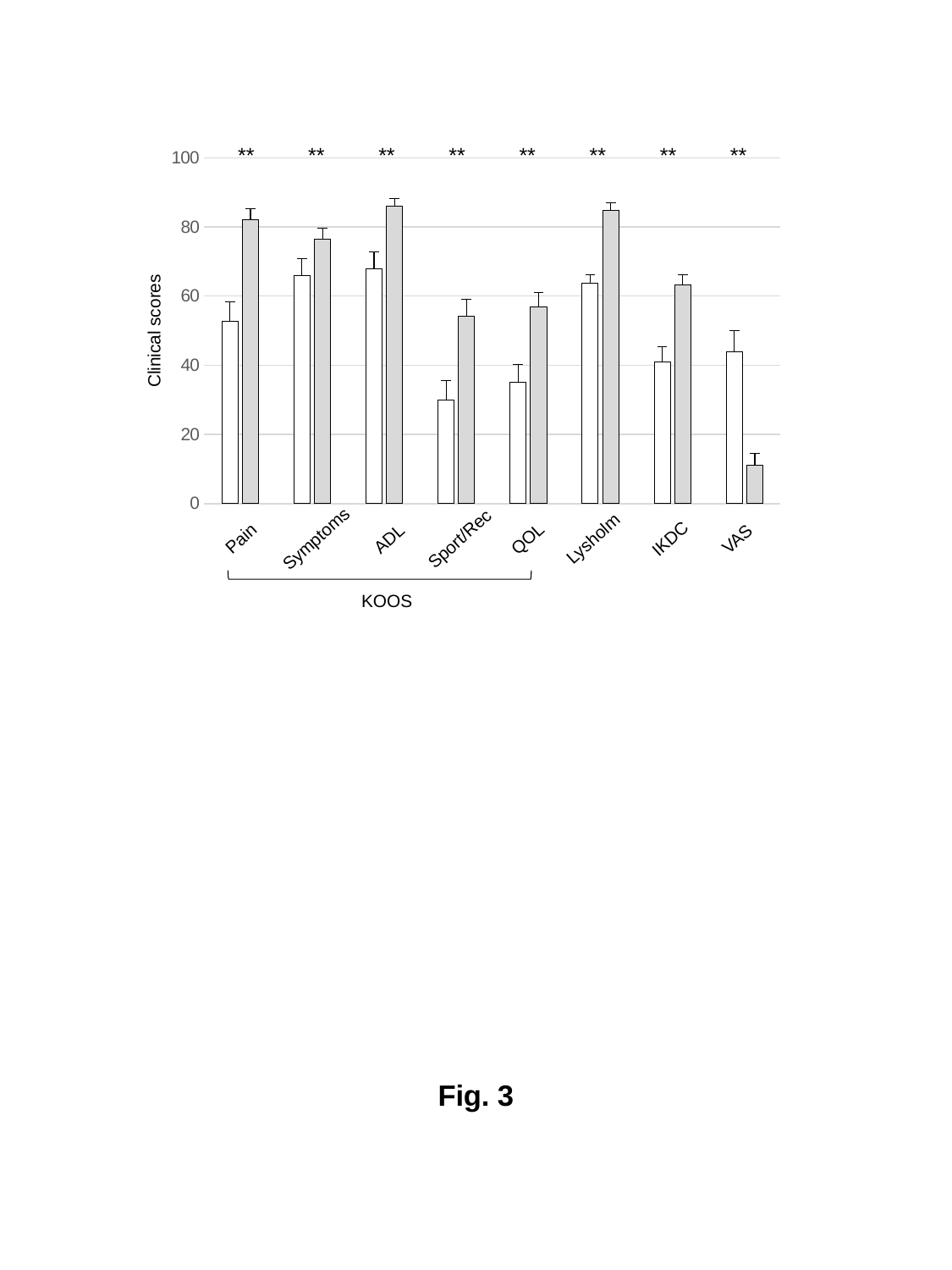
For VAS, which bar is larger, the white bar or the grey bar? the white bar Is the value of the white bar for Symptoms greater or less than 60? greater What is the label of the y axis? Clinical scores How many bars are plotted for each category in the chart? 2 Which category has the lowest grey bar? VAS How many categories are shown along the x axis of the chart? 8 Which group label is shown under the bracket spanning the first five categories? KOOS Is the value of the white bar for Pain greater or less than 60? less What kind of chart is shown on the slide? bar chart Is the value of the white bar for Sport/Rec greater or less than 40? less